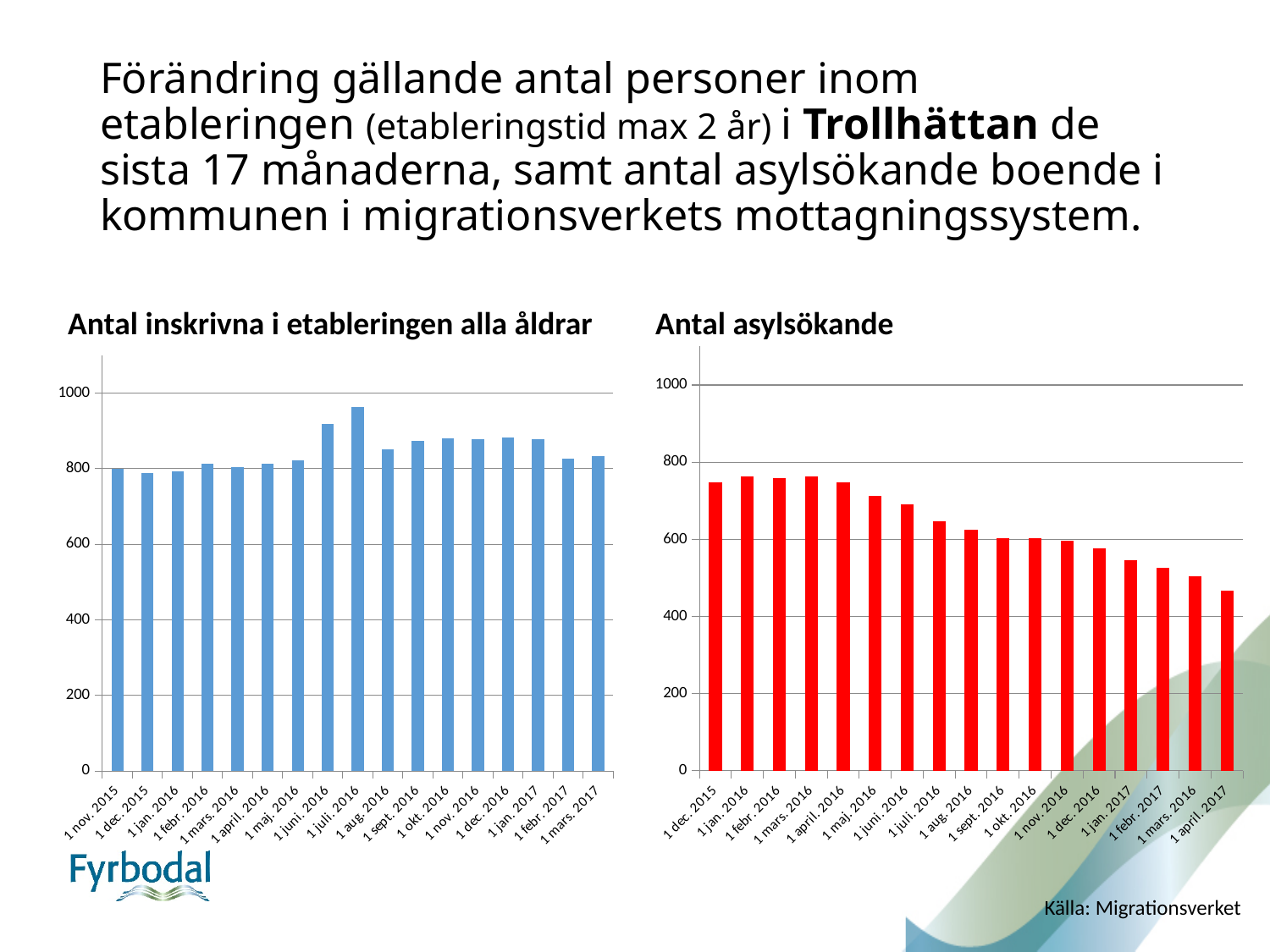
What colour are the bars in the 'Antal asylsökande' chart? red What kind of chart is the 'Antal asylsökande' chart? bar chart In the 'Antal asylsökande' chart, is the value for 1 april. 2017 greater or less than 600? less In the 'Antal asylsökande' chart, do the values generally rise or fall from left to right along the x axis? fall In the 'Antal inskrivna i etableringen alla åldrar' chart, which is larger: the value for 1 juli. 2016 or the value for 1 nov. 2015? 1 juli. 2016 In the 'Antal inskrivna i etableringen alla åldrar' chart, which month has the highest value? 1 juli. 2016 In the 'Antal asylsökande' chart, is the value for 1 dec. 2015 greater or less than 600? greater In the 'Antal asylsökande' chart, which is larger: the value for 1 dec. 2015 or the value for 1 april. 2017? 1 dec. 2015 How many bars are plotted in the 'Antal asylsökande' chart? 17 In the 'Antal asylsökande' chart, which month has the lowest value? 1 april. 2017 In the 'Antal inskrivna i etableringen alla åldrar' chart, is the value for 1 juli. 2016 greater or less than 900? greater How many bars are plotted in the 'Antal inskrivna i etableringen alla åldrar' chart? 17